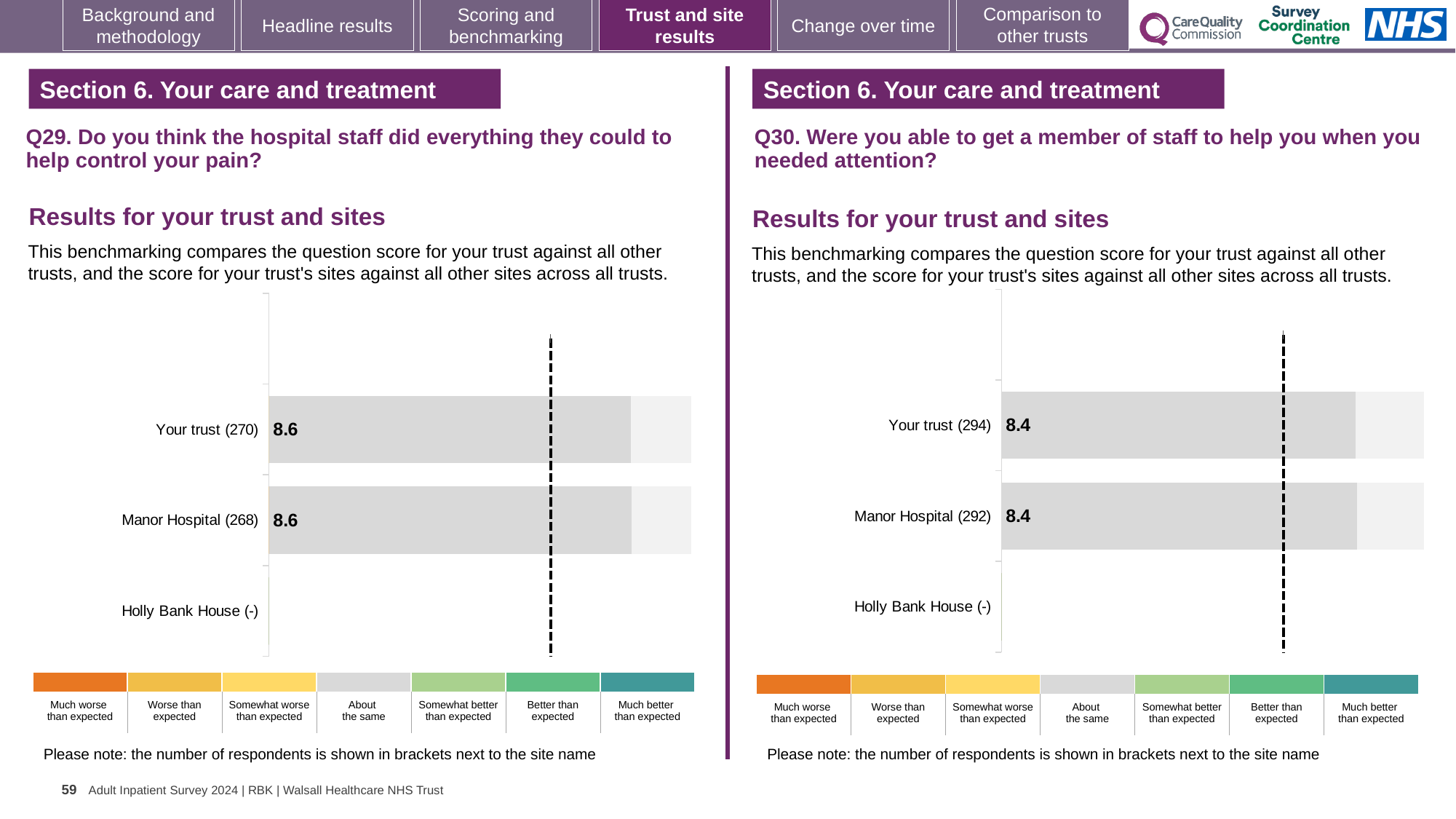
On the Q29 chart (left), how many respondents are shown in brackets for Your trust? 270 On the Q29 chart (left), how many benchmark categories are shown in the colour key below the chart? 7 On the Q30 chart (right), what is the score for Your trust? 8.4 On the Q29 chart (left), what is the score for Manor Hospital? 8.6 Is the Your trust score on the Q29 chart (left) larger or smaller than the Your trust score on the Q30 chart (right)? Larger On the Q29 chart (left), what is the score for Your trust? 8.6 On the Q30 chart (right), what is the score for Manor Hospital? 8.4 On the Q30 chart (right), which category has no score shown? Holly Bank House On the Q30 chart (right), how many site/trust categories are listed on the vertical axis? 3 What kind of chart is used on the Q29 chart (left)? Bar chart On the Q30 chart (right), how many respondents are shown in brackets for Manor Hospital? 292 On the Q29 chart (left), what is the difference between the scores for Your trust and Manor Hospital? 0.0